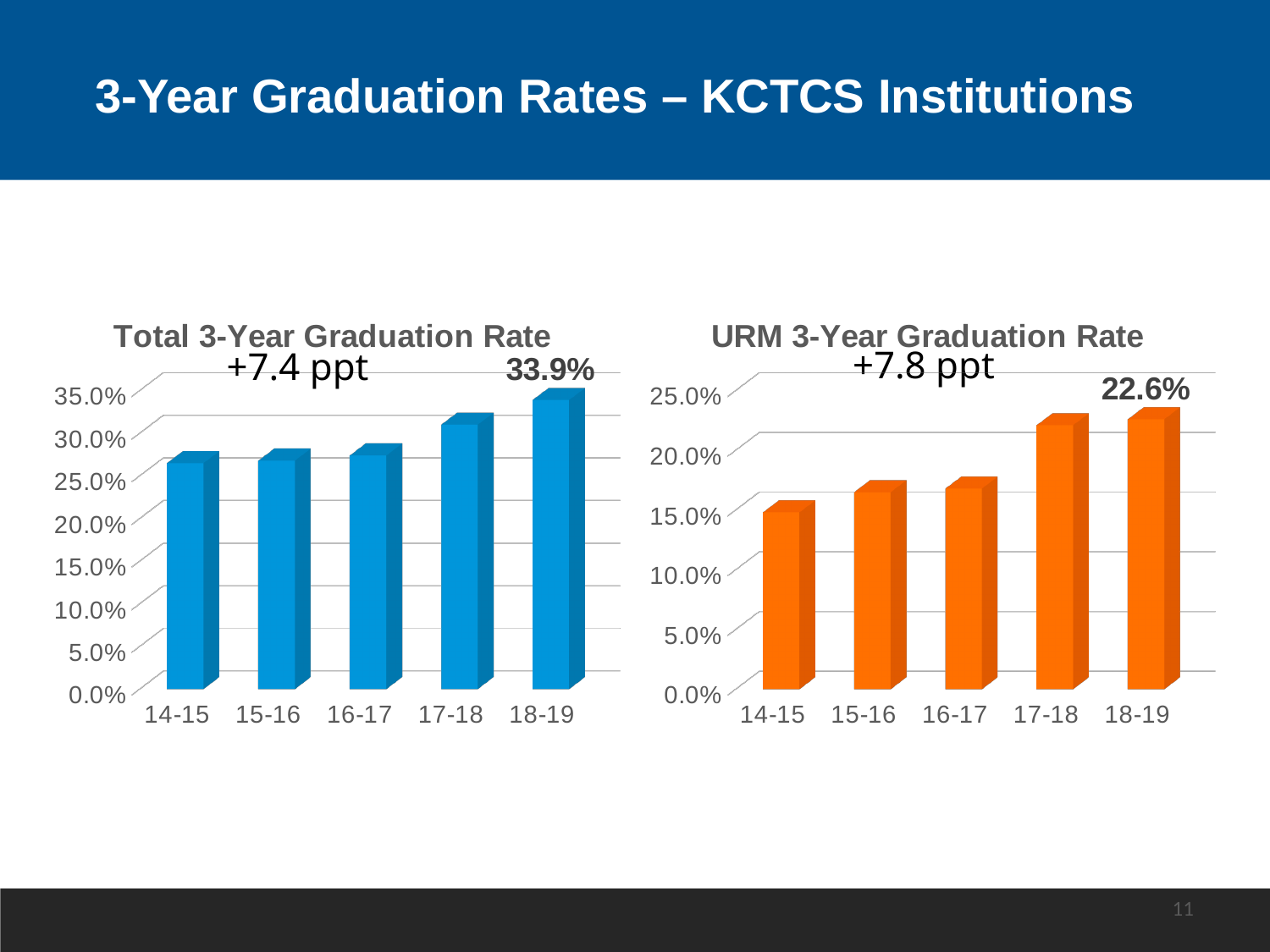
In the URM 3-Year Graduation Rate chart, which year has the lowest graduation rate? 14-15 In the URM 3-Year Graduation Rate chart, is the value for 17-18 greater or less than 20.0%? greater In the Total 3-Year Graduation Rate chart, which is larger, the value for 14-15 or the value for 18-19? 18-19 In the Total 3-Year Graduation Rate chart, what is the value for 18-19? 33.9% How many years are shown on the x axis of the Total 3-Year Graduation Rate chart? 5 In the Total 3-Year Graduation Rate chart, which year has the highest graduation rate? 18-19 In the URM 3-Year Graduation Rate chart, do the values rise or fall from 14-15 to 18-19? Rise In the URM 3-Year Graduation Rate chart, is the value for 14-15 greater or less than 20.0%? less What kind of chart is the URM 3-Year Graduation Rate chart? Bar chart What change in percentage points is annotated on the URM 3-Year Graduation Rate chart? +7.8 ppt In the Total 3-Year Graduation Rate chart, is the value for 17-18 greater or less than 30.0%? greater In the URM 3-Year Graduation Rate chart, what is the value for 18-19? 22.6%